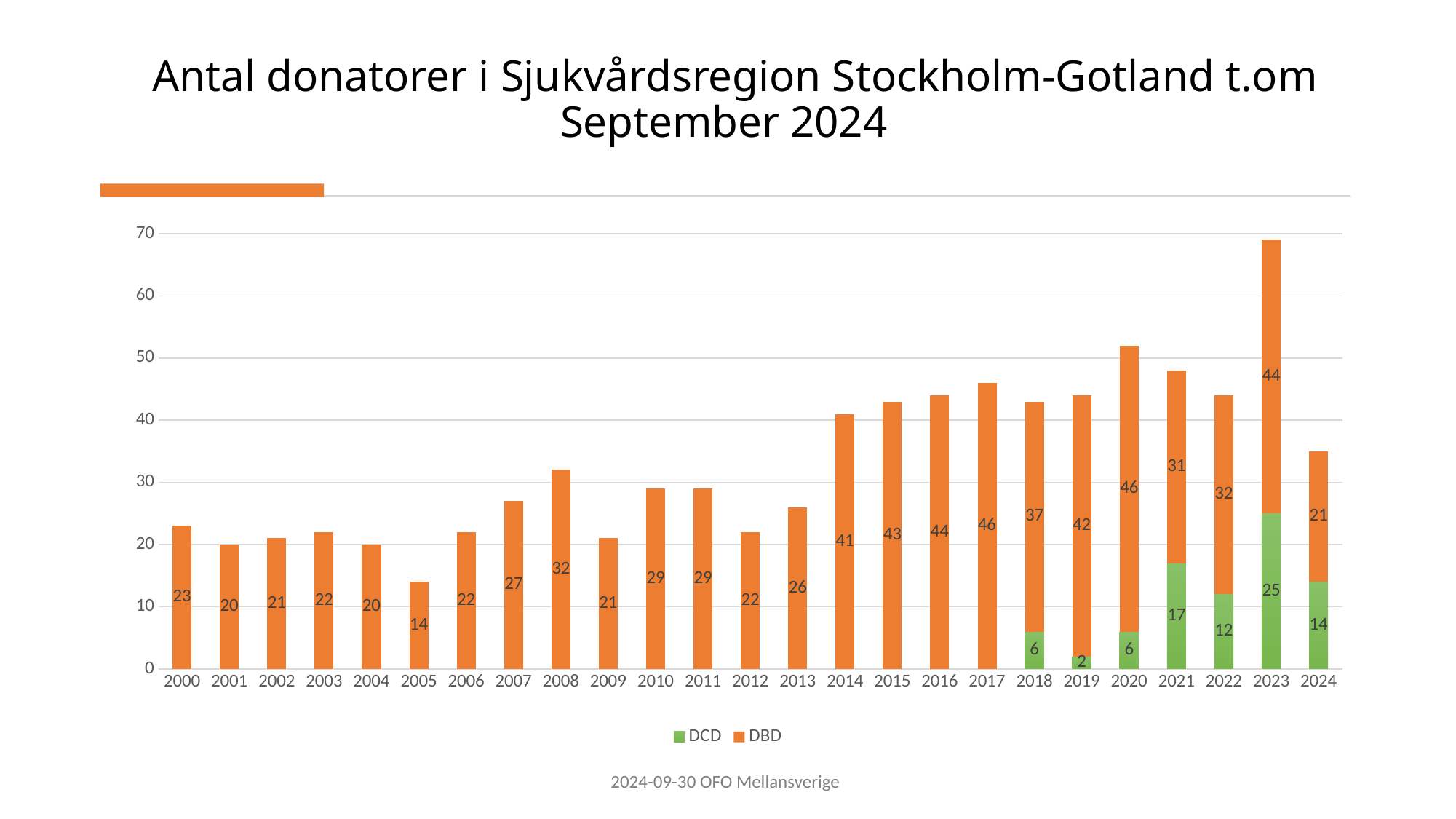
What kind of chart is shown on the slide? Stacked bar chart What is the total of the stacked bar for 2021? 48 Which year has the highest DCD value? 2023 What is the total of the stacked bar for 2023? 69 What is the DBD value for 2008? 32 What is the difference between the DBD values for 2017 and 2000? 23 How many years are shown on the x axis? 25 What is the DCD value for 2021? 17 How many series does the legend list? 2 Which year has the lowest DBD value? 2005 Which is larger, the DBD value for 2014 or the DBD value for 2013? 2014 What is the DBD value for 2024? 21